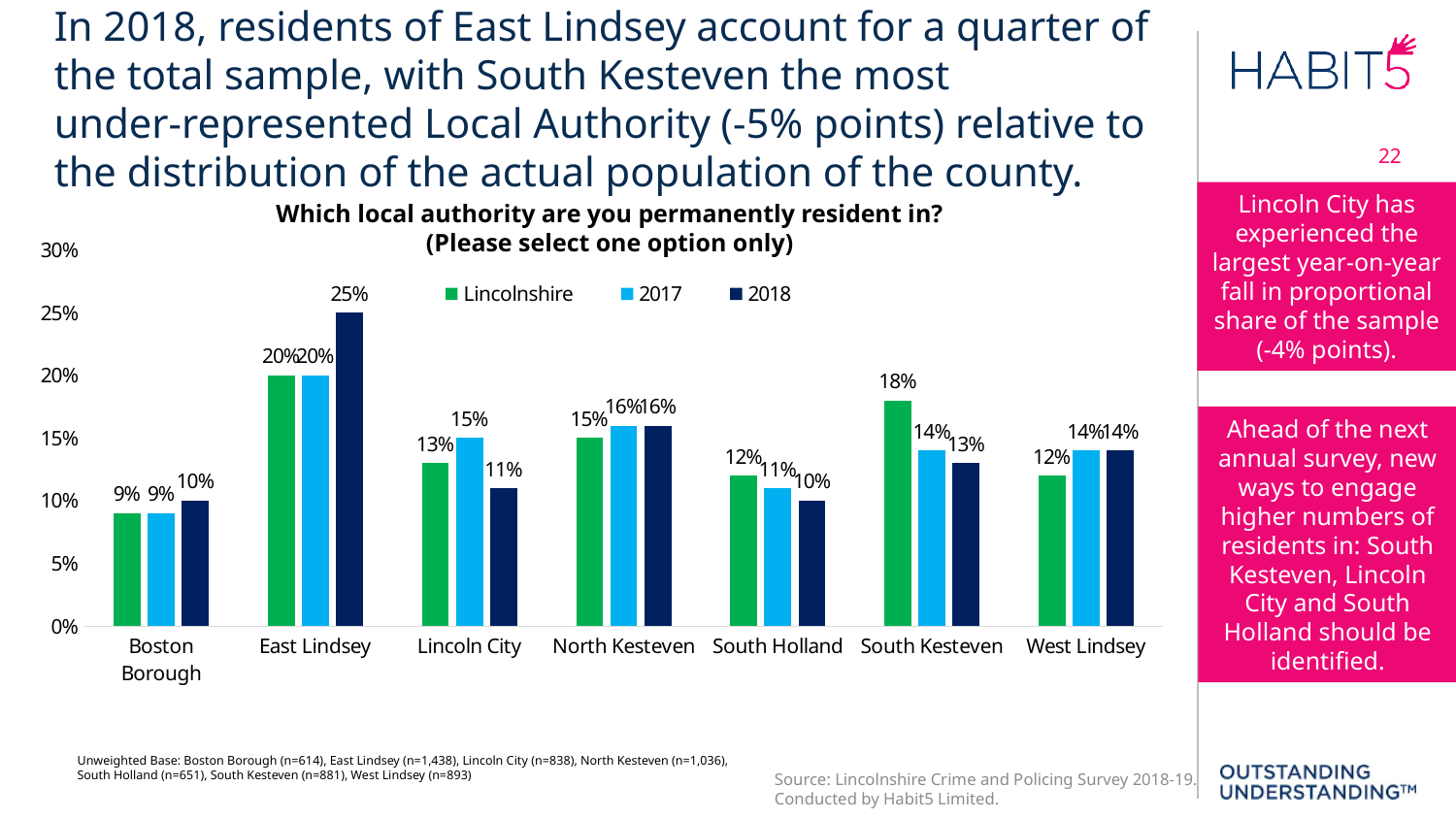
For Lincoln City, which is larger: the 2017 value or the 2018 value? 2017 By how much did the East Lindsey value increase from 2017 to 2018? 5% How many series does the legend list? 3 What is the 2018 value for East Lindsey? 25% Which local authority has the lowest Lincolnshire value? Boston Borough What is the 2018 value for West Lindsey? 14% What is the difference between the Lincolnshire value and the 2018 value for South Kesteven? 5% What is the Lincolnshire value for South Kesteven? 18% How many local authorities are shown on the x axis? 7 What is the 2017 value for Lincoln City? 15% What kind of chart is shown on the slide? Bar chart Which local authority has the highest 2018 value? East Lindsey